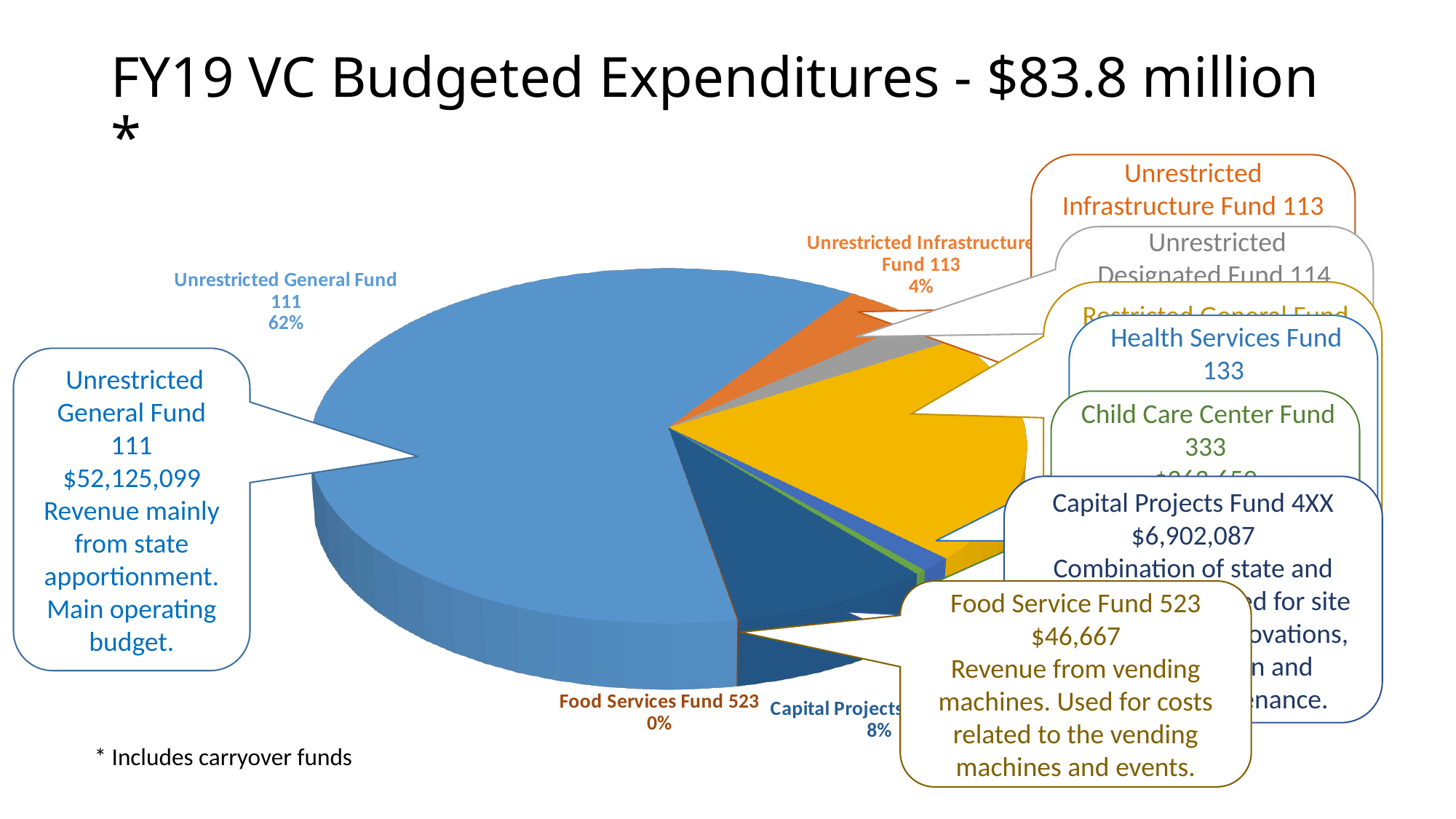
What is the difference in percentage points between the Unrestricted General Fund 111 share and the Capital Projects share? 54 According to the callout, what is the budgeted amount for Capital Projects Fund 4XX? $6,902,087 What kind of chart is shown on the slide? pie chart What percentage is shown for Capital Projects? 8% What share of the pie does Unrestricted Infrastructure Fund 113 represent? 4% What is the title of the slide containing the pie chart? FY19 VC Budgeted Expenditures - $83.8 million * Which fund has the largest slice of the pie? Unrestricted General Fund 111 According to the callout, what is the budgeted amount for Unrestricted General Fund 111? $52,125,099 What percentage is shown for Food Services Fund 523? 0% Which labelled fund has the smallest share of the pie? Food Services Fund 523 What share of the pie does Unrestricted General Fund 111 represent? 62% Which is larger, the share for Capital Projects or the share for Unrestricted Infrastructure Fund 113? Capital Projects